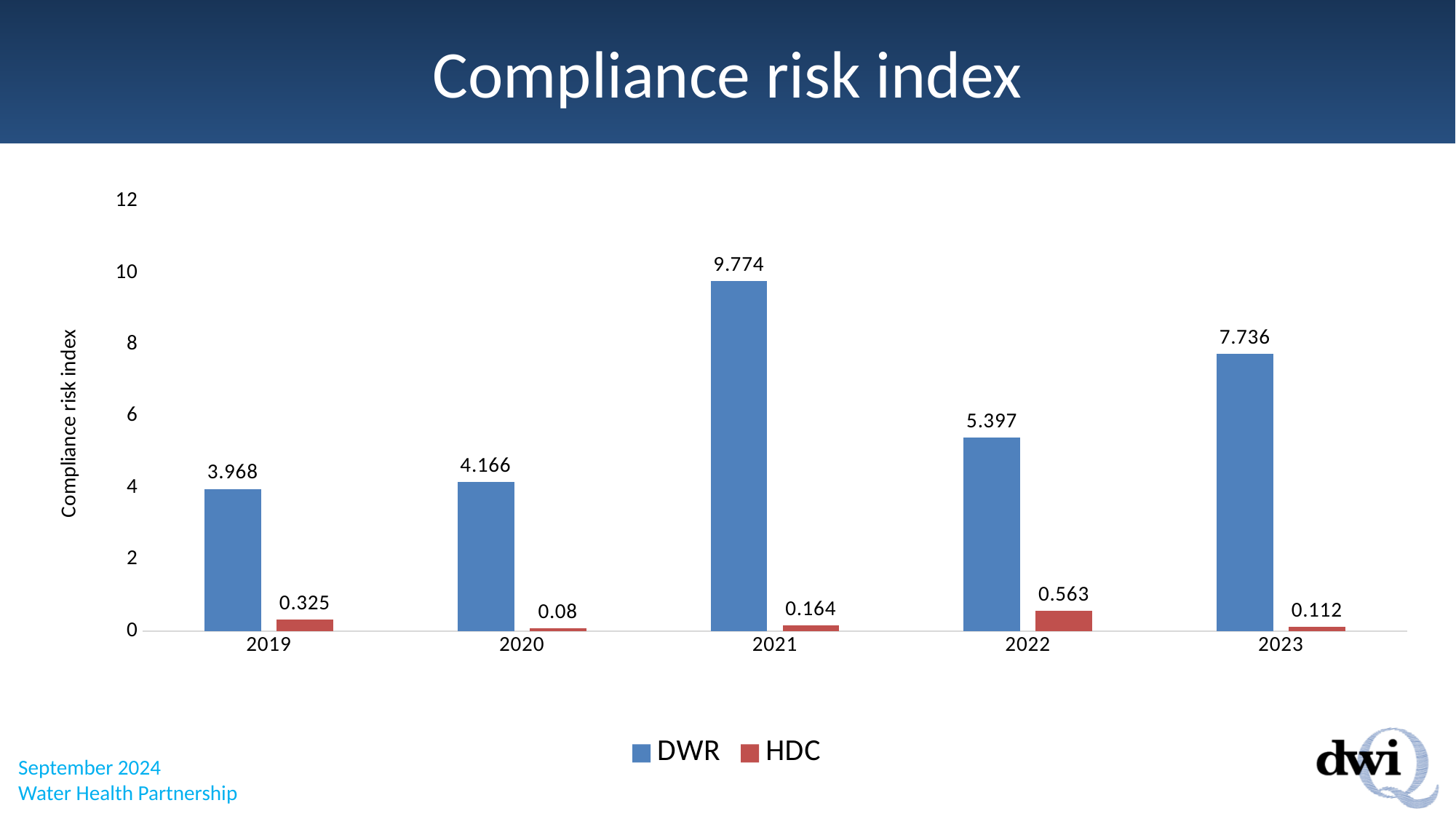
Which is larger, the DWR value for 2023 or the DWR value for 2022? 2023 What kind of chart is shown on the slide? Bar chart What is the HDC compliance risk index value for 2022? 0.563 How many series does the legend list? 2 What is the difference between the DWR values for 2021 and 2022? 4.377 What is the HDC value for 2020? 0.08 What is the DWR value for 2019? 3.968 How many years are shown on the x axis? 5 In which year is the DWR compliance risk index highest? 2021 In which year is the HDC compliance risk index lowest? 2020 What is the DWR compliance risk index value for 2021? 9.774 What is the label on the vertical axis? Compliance risk index